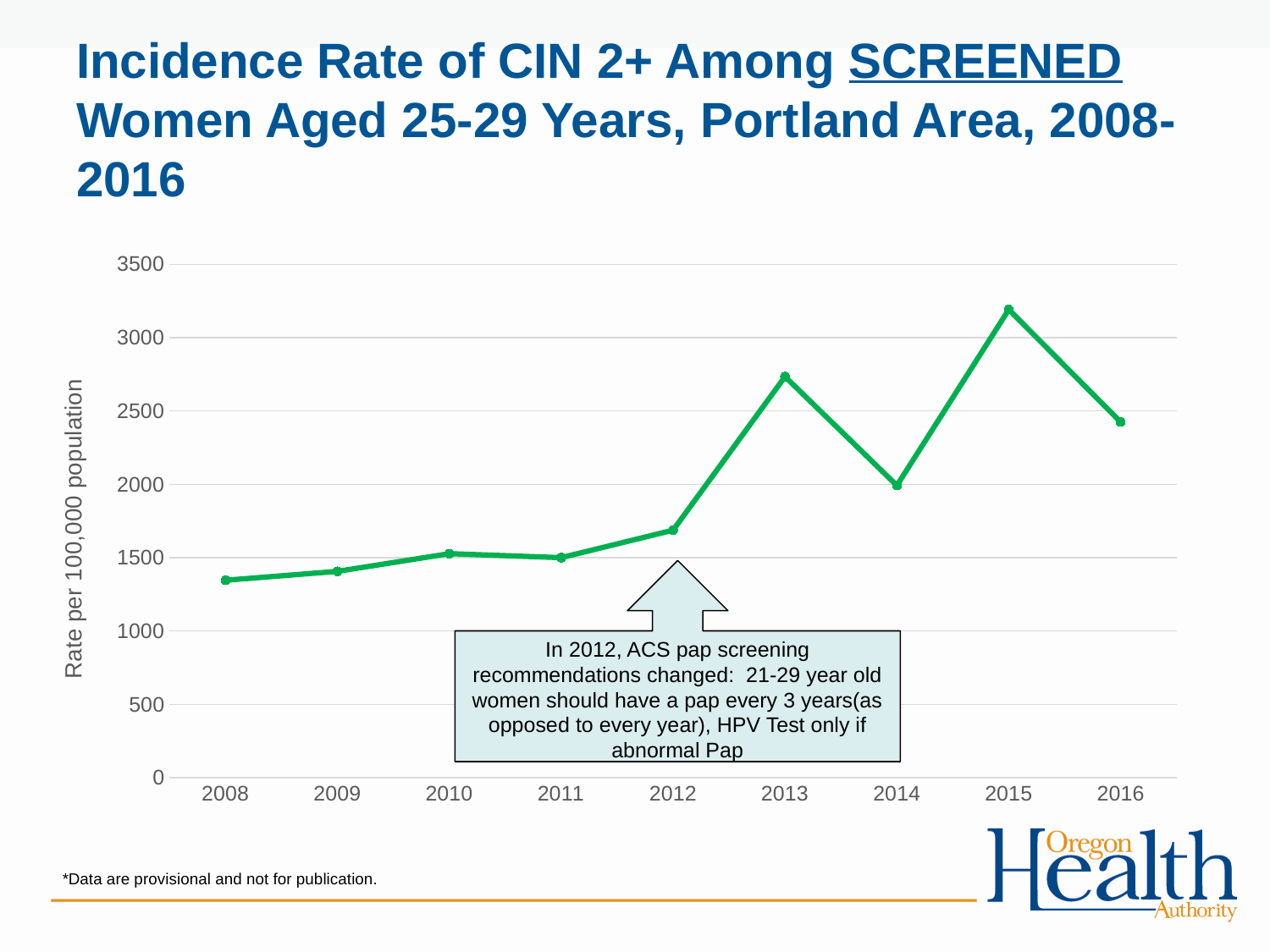
Is the value for 2008 greater or less than 1500? less What is the first year shown on the x axis? 2008 Which year has the lowest incidence rate? 2008 Which year has the larger incidence rate, 2013 or 2014? 2013 How many years are plotted on the x axis? 9 Which year has the highest incidence rate? 2015 Does the incidence rate rise or fall from 2015 to 2016? fall Is the value for 2013 greater or less than 2500? greater What is the label on the y axis? Rate per 100,000 population What type of chart is shown on the slide? line chart Is the value for 2015 greater or less than 3000? greater